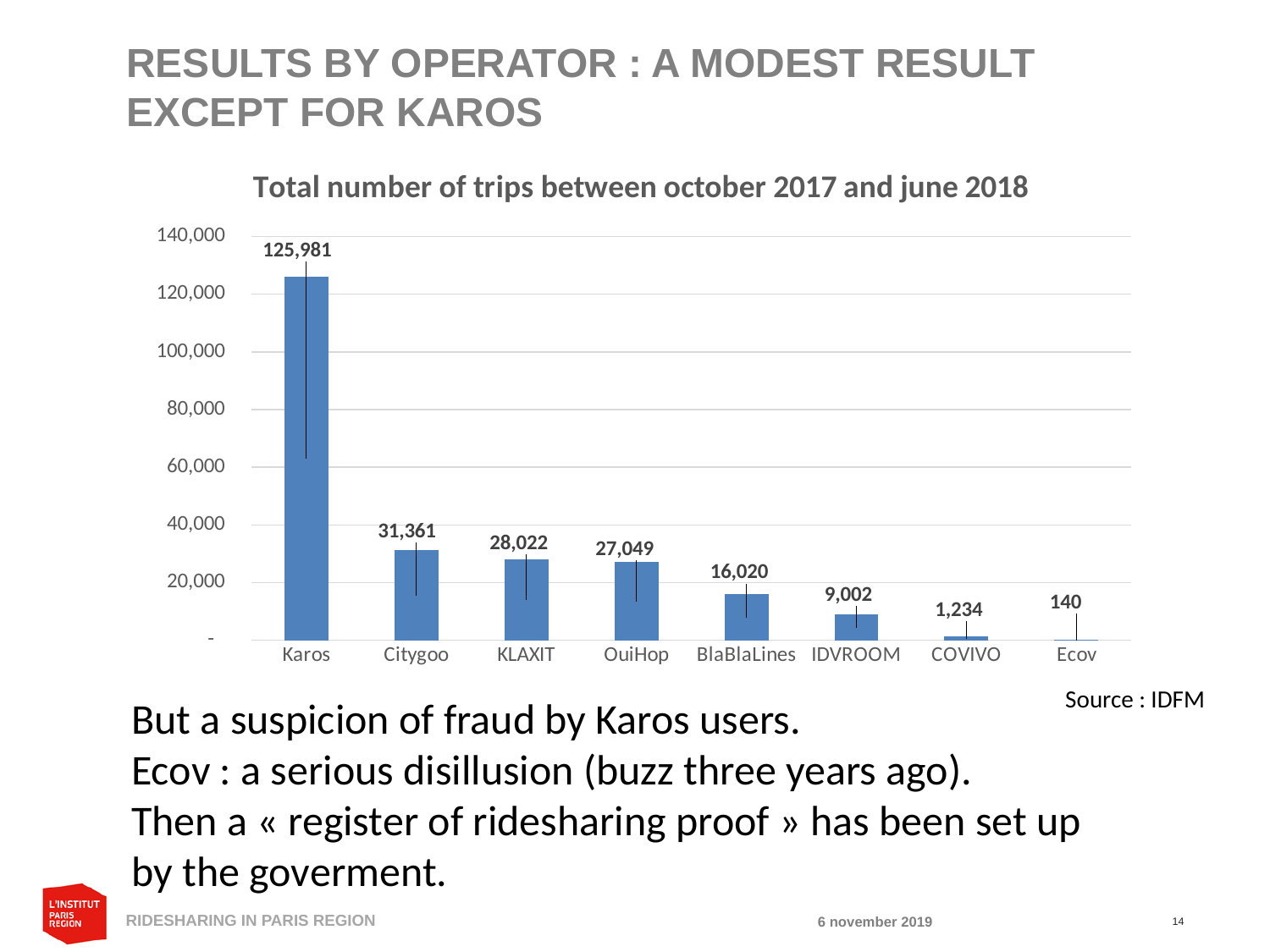
Which operator has the highest number of trips? Karos What is the difference in trips between Citygoo and KLAXIT? 3,339 What is the total number of trips for Karos? 125,981 Which operator has the lowest number of trips? Ecov Is the value for Citygoo greater or less than 40,000? less What is the title of the chart? Total number of trips between october 2017 and june 2018 Which operator has more trips, OuiHop or BlaBlaLines? OuiHop How many operators are shown on the chart? 8 What kind of chart is shown on the slide? Bar chart What is the total number of trips for COVIVO? 1,234 What is the total number of trips for BlaBlaLines? 16,020 What is the difference in trips between IDVROOM and COVIVO? 7,768